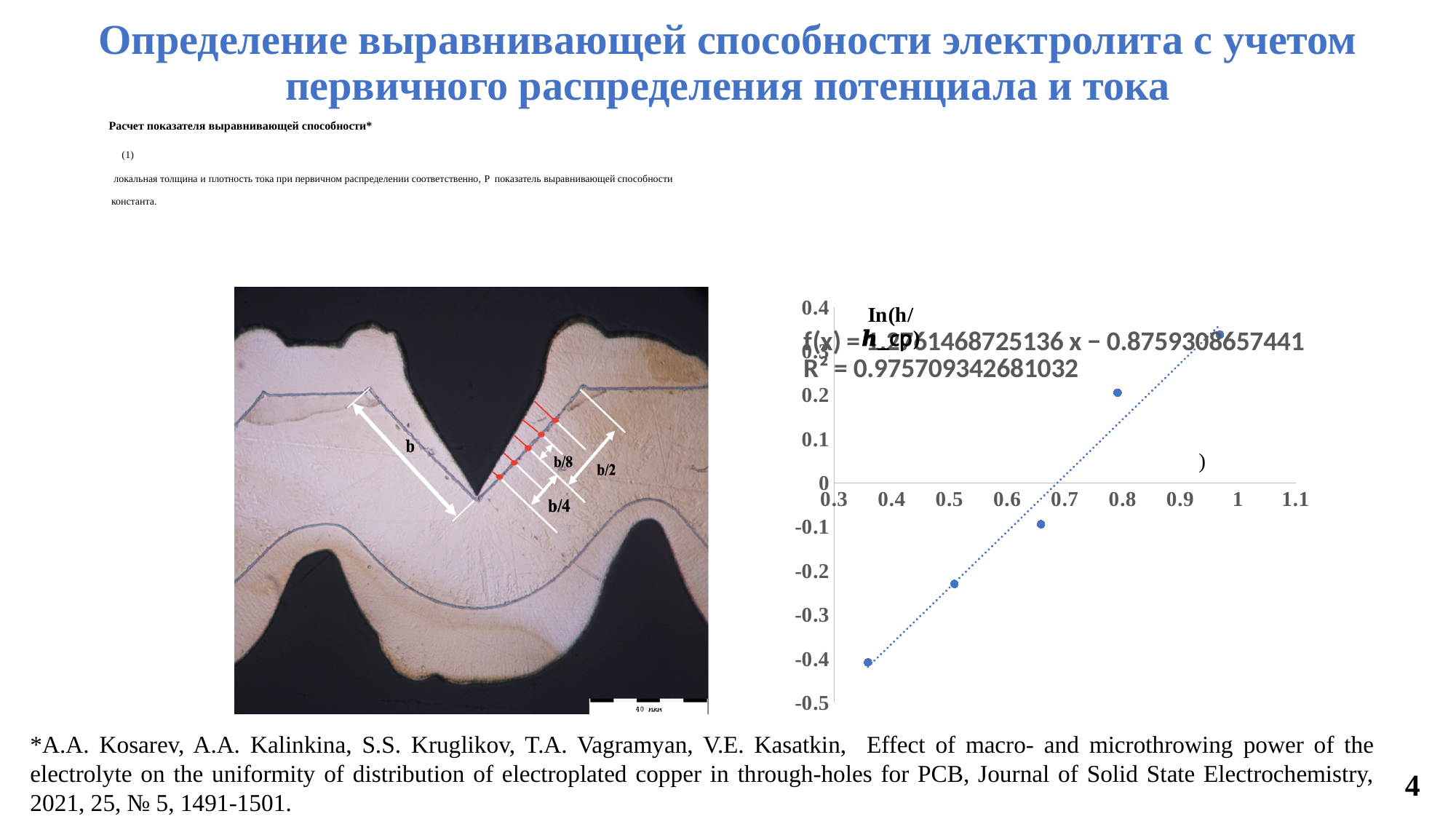
Is the y value of the rightmost point in the scatter chart greater or less than 0.2? greater What is the highest value shown on the y axis of the scatter chart? 0.4 What kind of chart is shown on the right side of the slide? scatter chart Which point in the scatter chart has the lowest y value: the leftmost point or the rightmost point? the leftmost point What R² value is displayed for the trendline in the scatter chart? R² = 0.975709342681032 Do the plotted values in the scatter chart rise or fall as x increases? rise Is the y value of the leftmost point in the scatter chart greater or less than -0.3? less Is the y value of the point near x = 0.5 in the scatter chart greater or less than -0.1? less How many data points are plotted in the scatter chart? 5